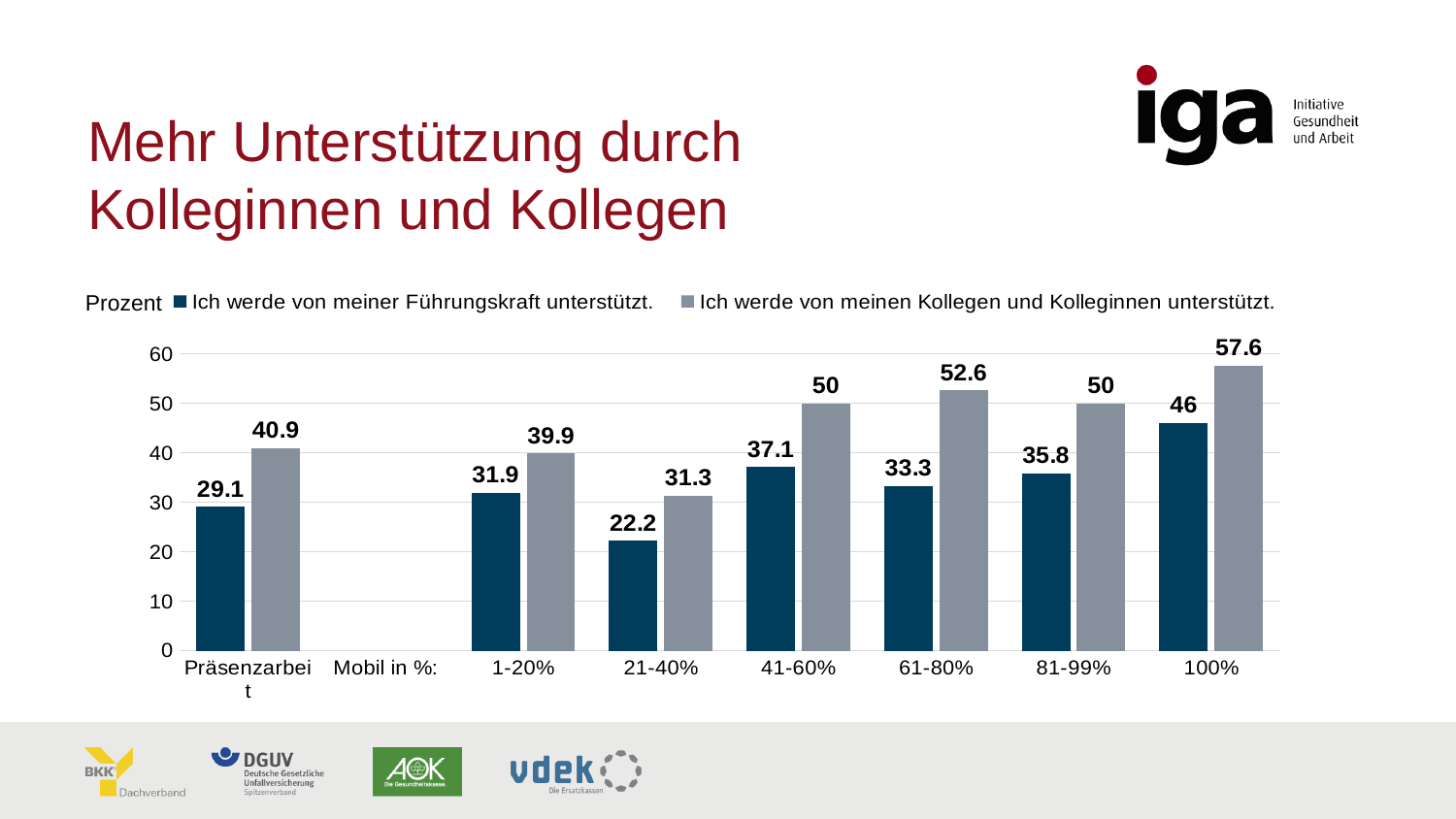
What unit label is shown at the top left of the chart's vertical axis? Prozent Which category has the lowest value for 'Ich werde von meinen Kollegen und Kolleginnen unterstützt.'? 21-40% How many categories have bars plotted in the chart? 7 What type of chart is shown on the slide? bar chart Which category has the highest value for 'Ich werde von meiner Führungskraft unterstützt.'? 100% What is the value for 'Ich werde von meiner Führungskraft unterstützt.' in the Präsenzarbeit category? 29.1 How many series does the legend list? 2 What is the value for 'Ich werde von meinen Kollegen und Kolleginnen unterstützt.' in the 100% category? 57.6 What is the value for 'Ich werde von meiner Führungskraft unterstützt.' in the 21-40% category? 22.2 In the 41-60% category, which series has the larger value? Ich werde von meinen Kollegen und Kolleginnen unterstützt. What is the value for 'Ich werde von meinen Kollegen und Kolleginnen unterstützt.' in the 61-80% category? 52.6 What is the difference between the two series in the 100% category? 11.6